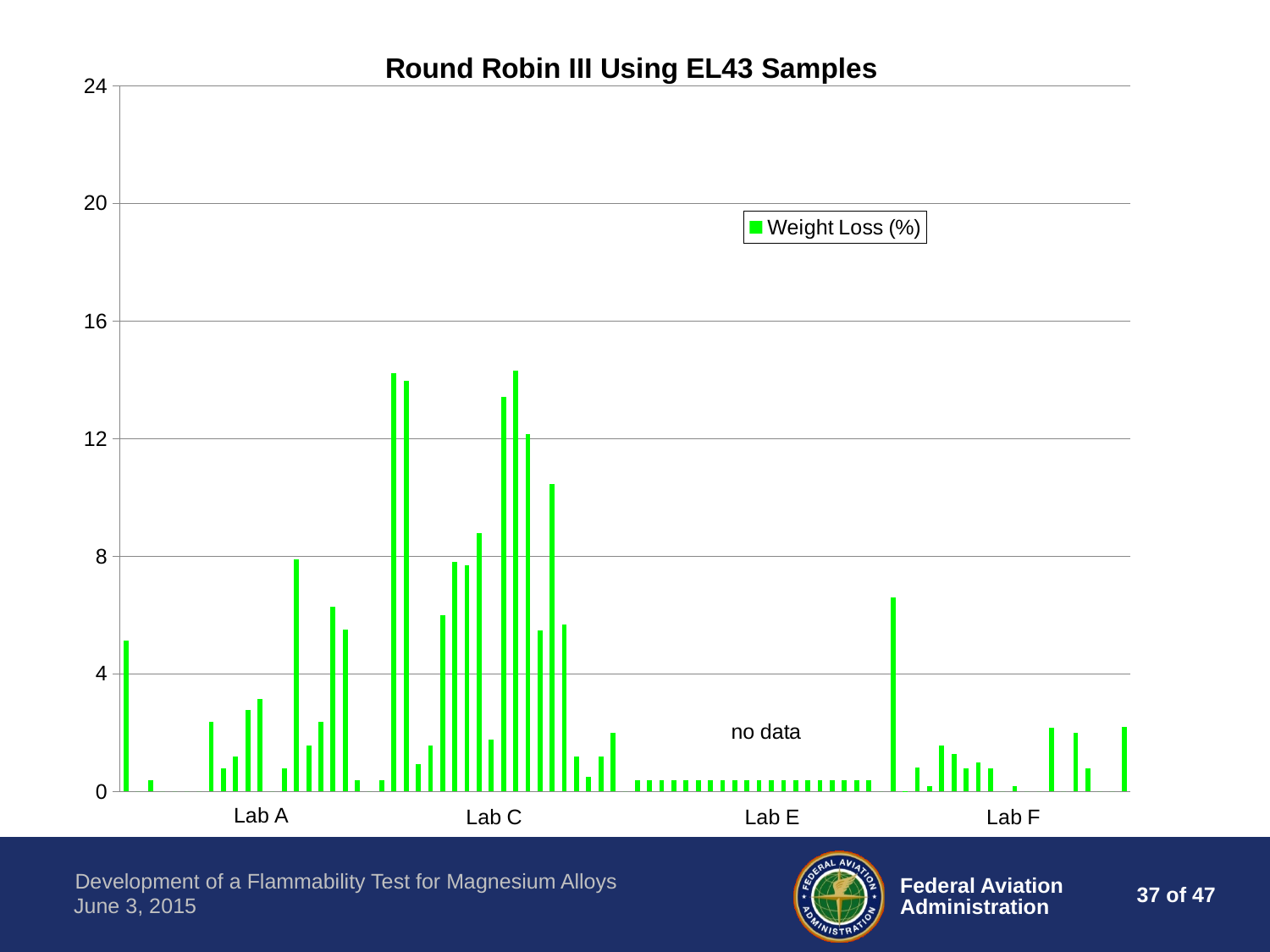
How many series does the legend list? 1 Is the tallest bar in the chart greater or less than 16? less What kind of chart is shown on the slide? bar chart What is the interval between consecutive tick marks on the y axis? 4 Is the first bar on the left of the chart greater or less than 8? less How many lab labels are readable along the x axis? 4 What series name appears in the legend? Weight Loss (%) Is the tallest bar in the chart greater or less than 12? greater What is the highest value shown on the y axis? 24 Which lab is marked with the annotation 'no data'? Lab E